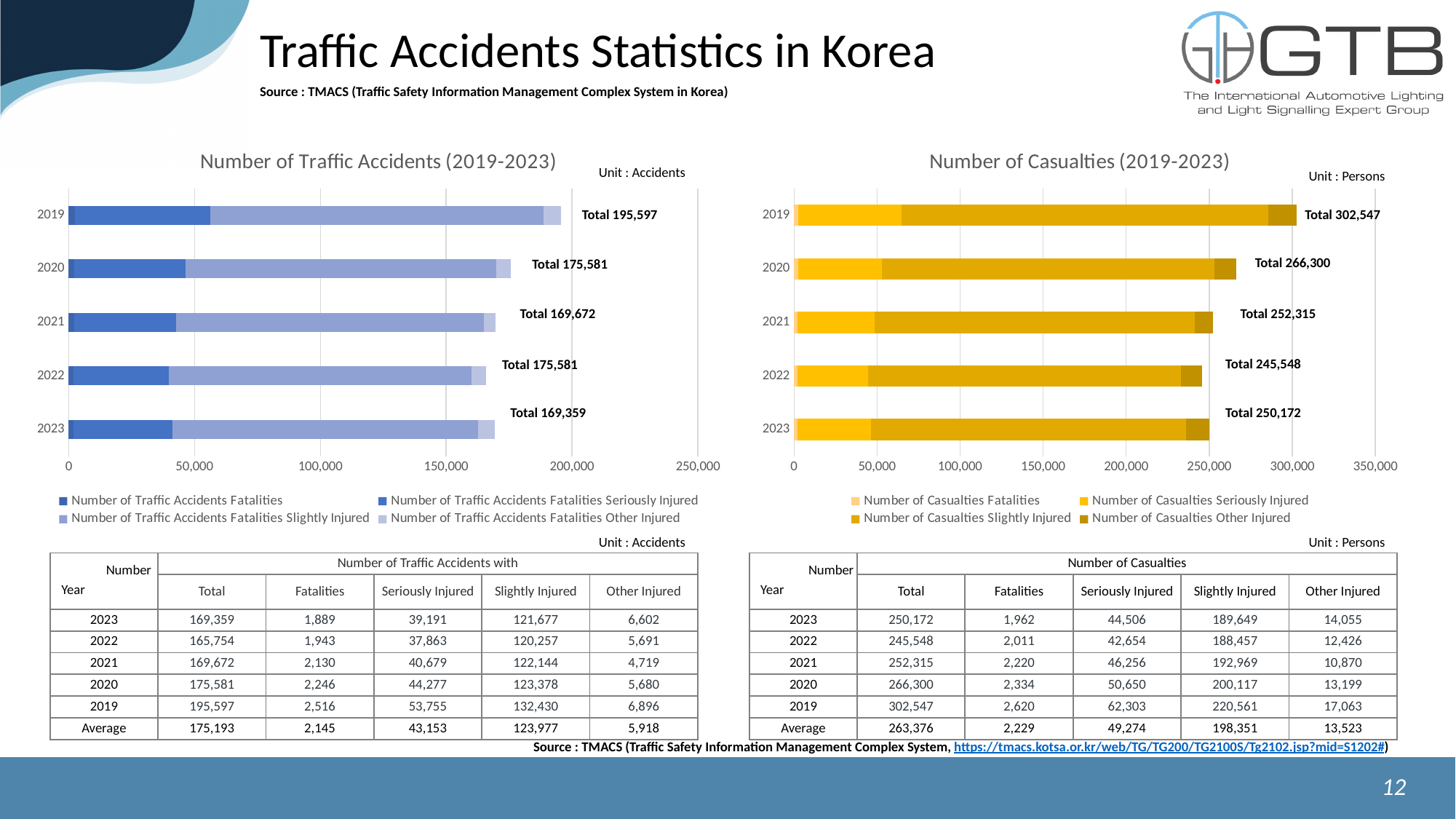
How many series does the legend of the 'Number of Traffic Accidents (2019-2023)' chart list? 4 How many years are plotted in the 'Number of Traffic Accidents (2019-2023)' chart? 5 In the 'Number of Traffic Accidents (2019-2023)' chart, what is the difference between the 2019 total and the 2023 total? 26,238 What kind of chart is the 'Number of Traffic Accidents (2019-2023)' chart? Stacked bar chart In the 'Number of Casualties (2019-2023)' chart, which year has the lowest total? 2022 In the 'Number of Traffic Accidents (2019-2023)' chart, which year has the highest total? 2019 In the 'Number of Casualties (2019-2023)' chart, is the total for 2019 greater or less than 300,000? greater In the 'Number of Casualties (2019-2023)' chart, which year has the larger total, 2021 or 2022? 2021 In the 'Number of Casualties (2019-2023)' chart, what is the difference between the 2019 total and the 2023 total? 52,375 In the 'Number of Casualties (2019-2023)' chart, what is the total for 2020? 266,300 In the 'Number of Traffic Accidents (2019-2023)' chart, what is the total for 2019? 195,597 What unit is stated for the 'Number of Casualties (2019-2023)' chart? Persons